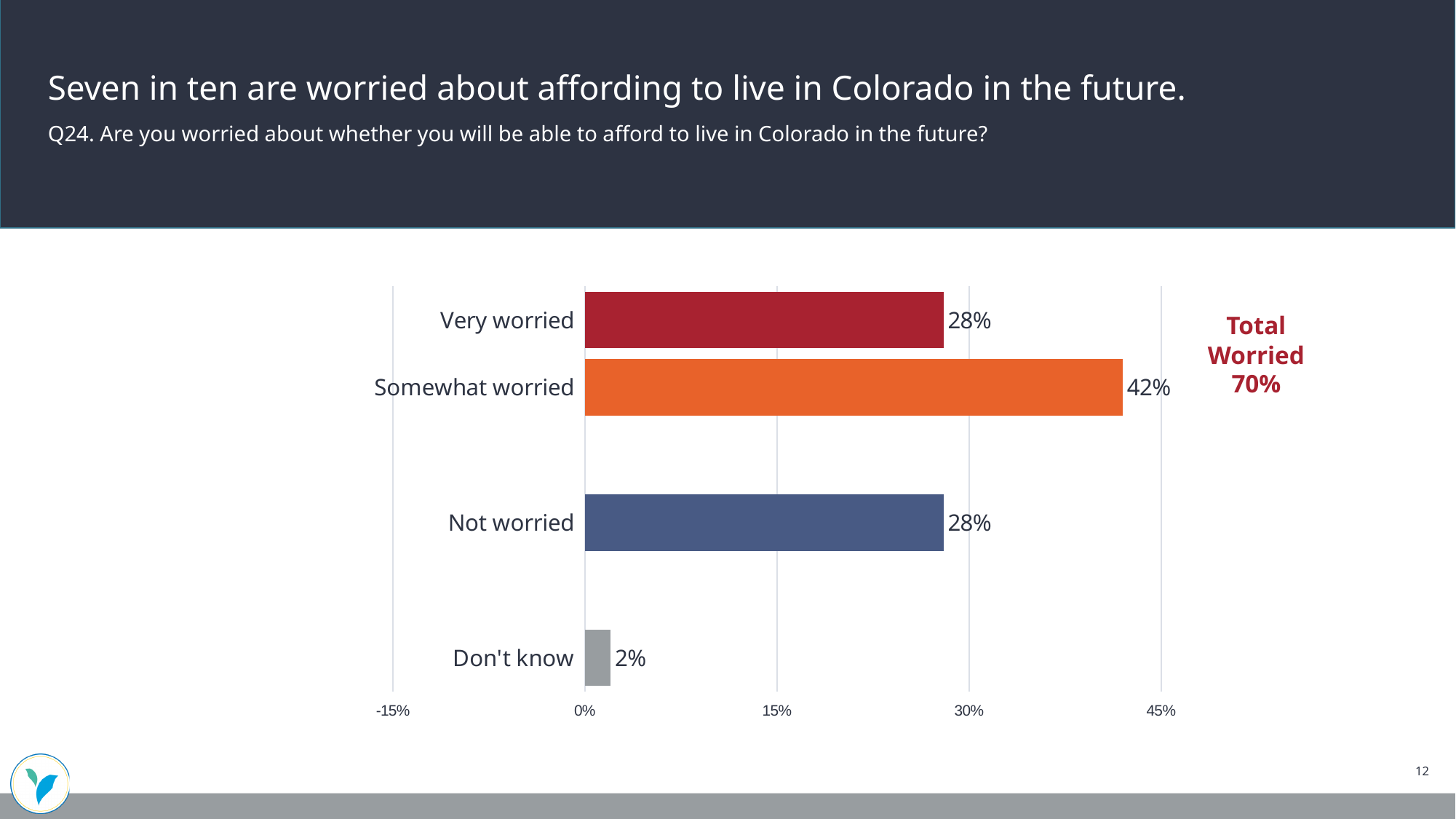
Which is larger, the percentage somewhat worried or the percentage not worried? Somewhat worried What percentage of respondents answered 'Don't know'? 2% How many response categories are shown in the chart? 4 Which response category has the lowest percentage? Don't know What kind of chart is shown on the slide? Bar chart What percentage of respondents are somewhat worried? 42% What is the difference between the percentage somewhat worried and the percentage very worried? 14% Which response category has the highest percentage? Somewhat worried What percentage of respondents are not worried? 28% What percentage of respondents are very worried about affording to live in Colorado in the future? 28% Is the value for 'Somewhat worried' greater or less than 30%? greater What total percentage is labelled as 'Total Worried' on the slide? 70%